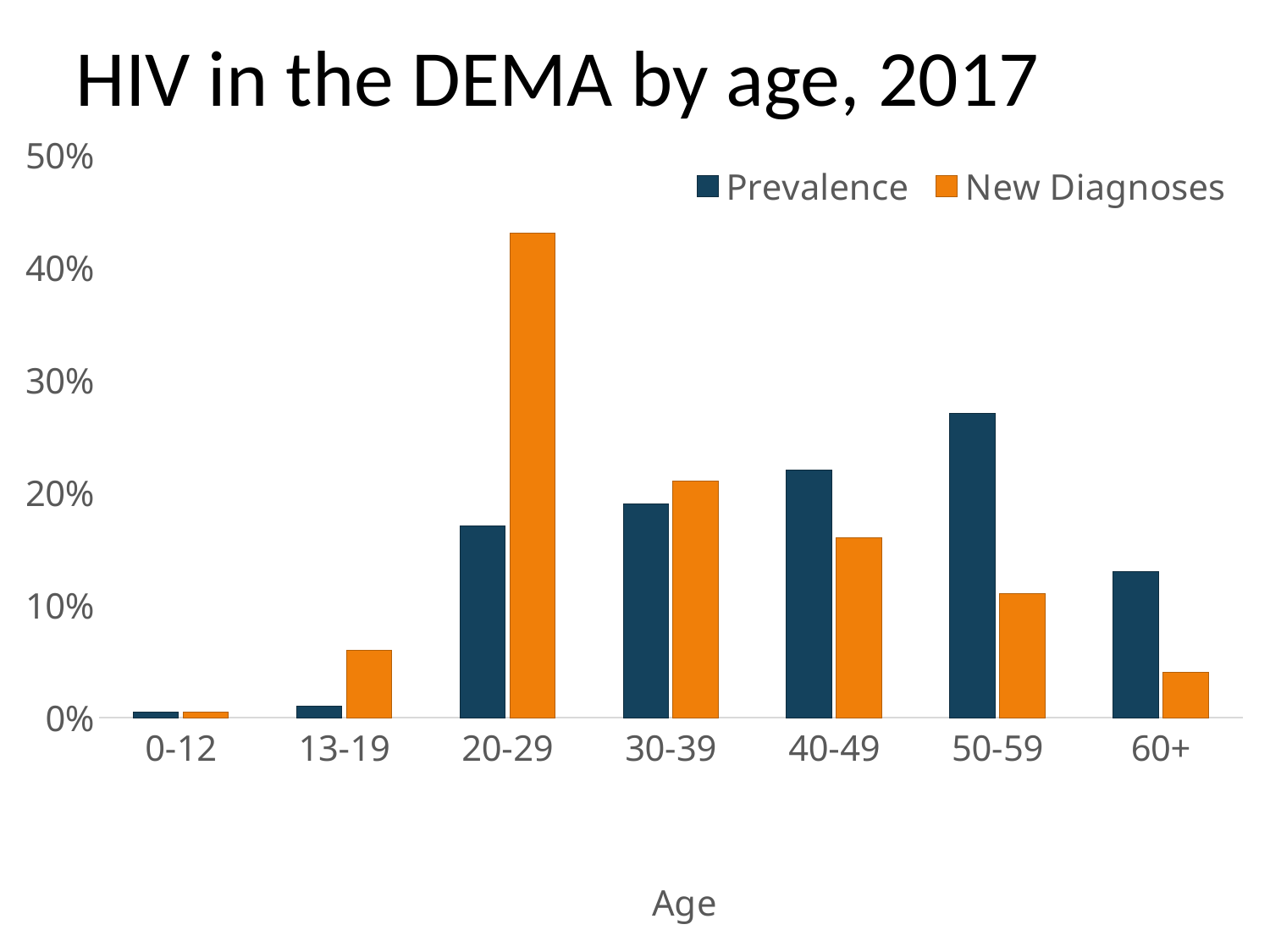
Is the New Diagnoses value for 60+ greater or less than 10%? less Which age group has the lowest New Diagnoses value? 0-12 Is the Prevalence value for 50-59 greater or less than 20%? greater For the 50-59 age group, which is larger: Prevalence or New Diagnoses? Prevalence Which age group has the highest Prevalence value? 50-59 What is the title of the chart? HIV in the DEMA by age, 2017 Is the New Diagnoses value for 20-29 greater or less than 40%? greater How many age categories are shown on the x axis? 7 What type of chart is shown on the slide? Bar chart Which age group has the highest New Diagnoses value? 20-29 For the 20-29 age group, which is larger: Prevalence or New Diagnoses? New Diagnoses How many series does the legend list? 2